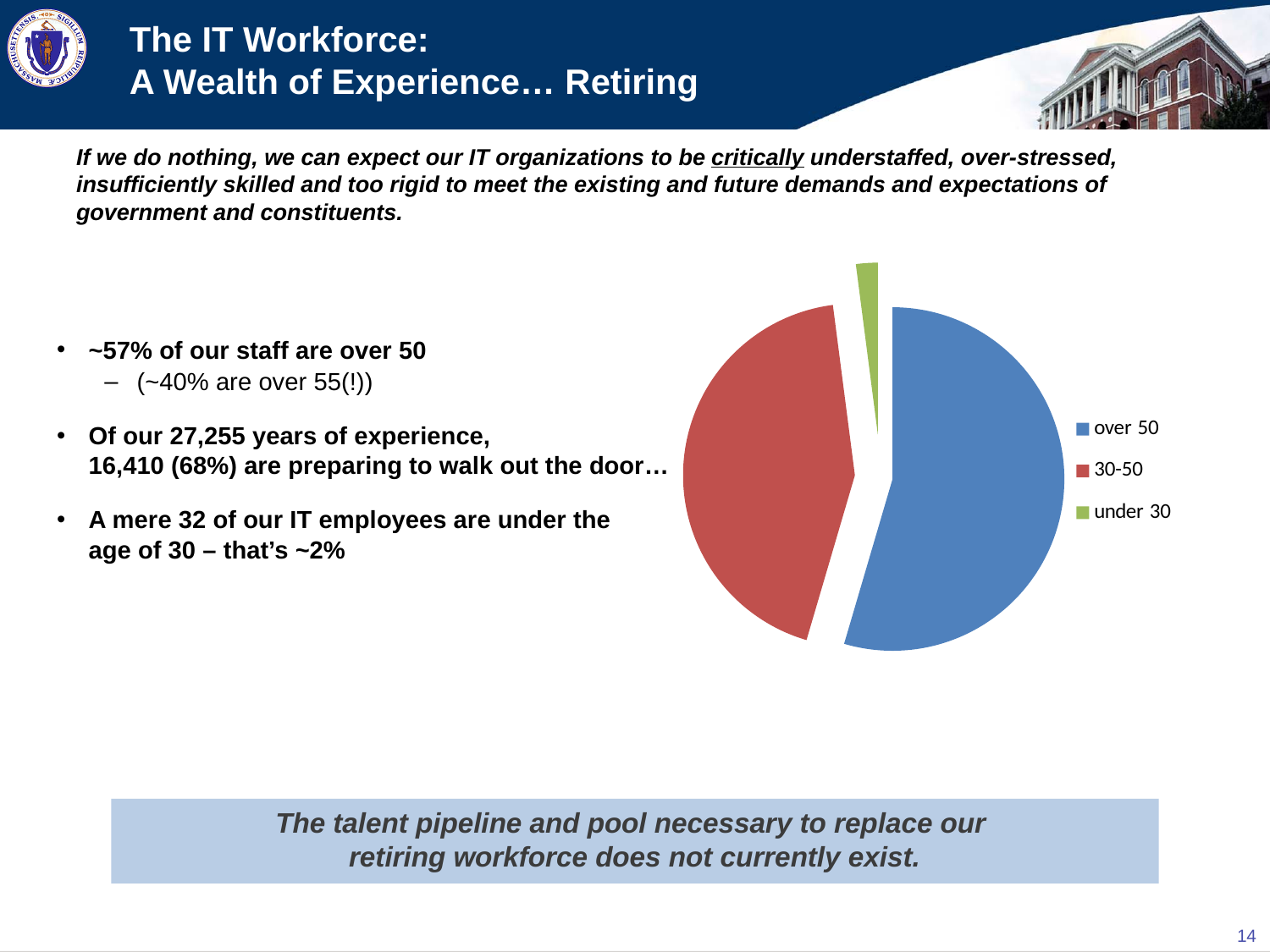
Which slice is larger in the pie chart, 30-50 or under 30? 30-50 Which category has the largest slice of the pie chart? over 50 What colour is the over 50 slice in the pie chart? blue Which slice is larger in the pie chart, over 50 or 30-50? over 50 What kind of chart is shown on the slide? pie chart Which category is shown in green in the pie chart? under 30 How many entries does the legend of the pie chart list? 3 Which slice is smaller in the pie chart, under 30 or over 50? under 30 Which category has the smallest slice of the pie chart? under 30 How many slices does the pie chart have? 3